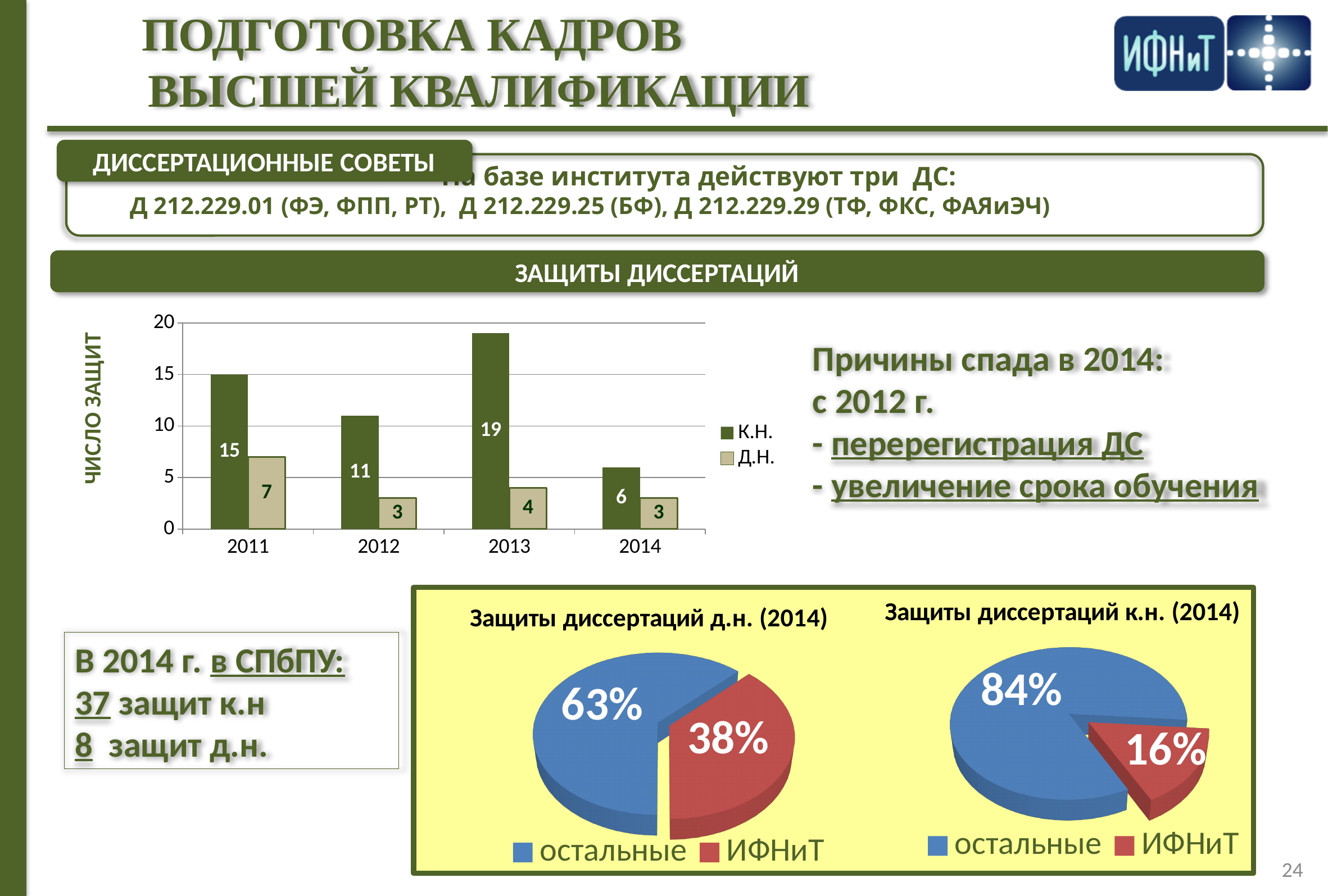
In the bar chart 'ЗАЩИТЫ ДИССЕРТАЦИЙ', which year has the highest К.Н. value? 2013 In the bar chart 'ЗАЩИТЫ ДИССЕРТАЦИЙ', how many years are shown on the x axis? 4 In the pie chart 'Защиты диссертаций к.н. (2014)', what colour is the ИФНиТ slice? red In the bar chart 'ЗАЩИТЫ ДИССЕРТАЦИЙ', how many series does the legend list? 2 In the pie chart 'Защиты диссертаций к.н. (2014)', what share does остальные have? 84% In the bar chart 'ЗАЩИТЫ ДИССЕРТАЦИЙ', what is the value for К.Н. in 2013? 19 In the bar chart 'ЗАЩИТЫ ДИССЕРТАЦИЙ', which is larger: К.Н. in 2011 or К.Н. in 2012? К.Н. in 2011 In the bar chart 'ЗАЩИТЫ ДИССЕРТАЦИЙ', what is the difference between the К.Н. values for 2013 and 2014? 13 In the bar chart 'ЗАЩИТЫ ДИССЕРТАЦИЙ', what is the value for Д.Н. in 2011? 7 In the pie chart 'Защиты диссертаций д.н. (2014)', what share does ИФНиТ have? 38% In the bar chart 'ЗАЩИТЫ ДИССЕРТАЦИЙ', which year has the lowest К.Н. value? 2014 What kind of chart is 'ЗАЩИТЫ ДИССЕРТАЦИЙ'? bar chart